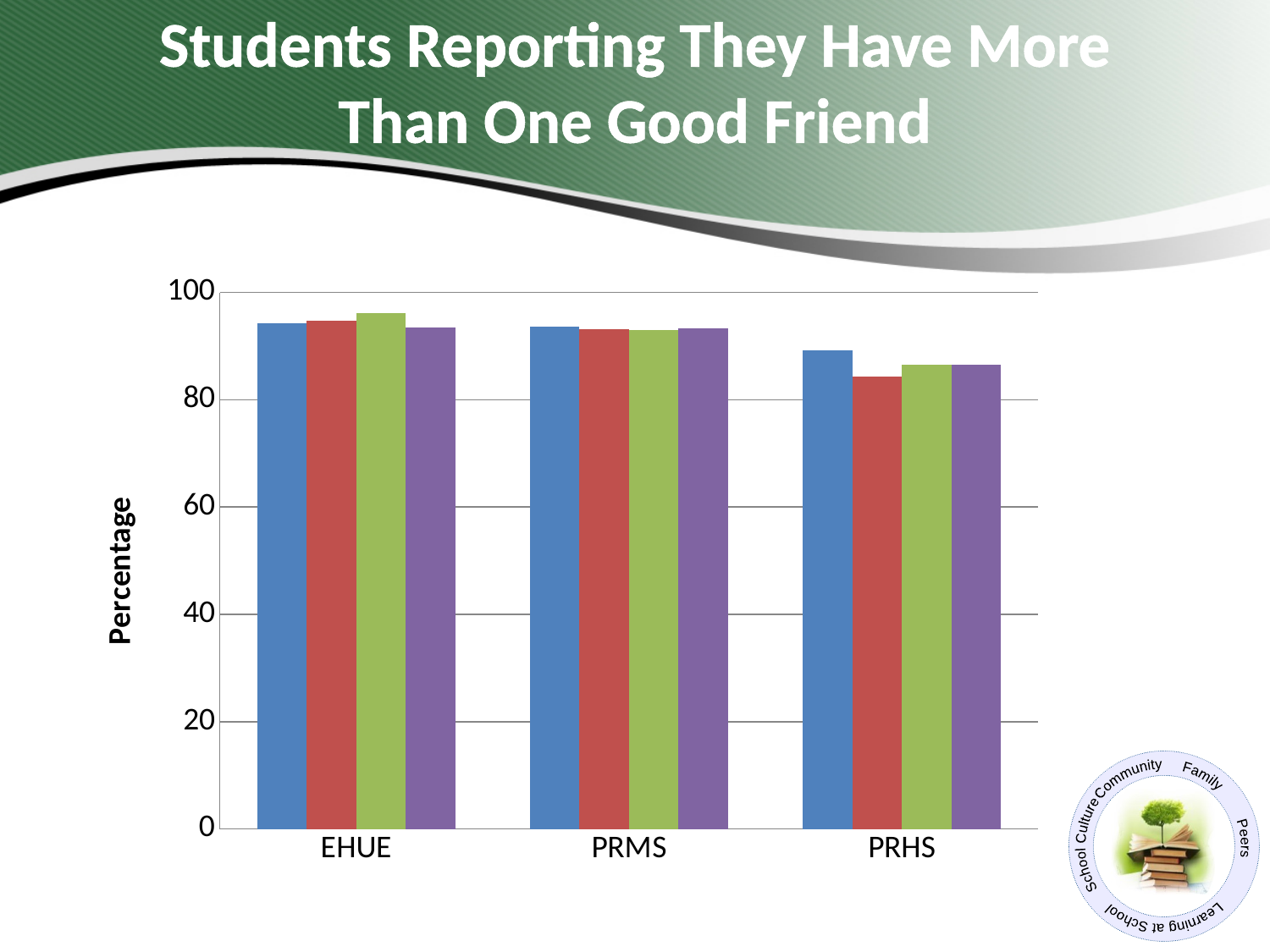
Which is larger for PRHS, the blue bar or the red bar? the blue bar How many categories are shown on the x axis of the chart? 3 Is the value of the blue bar for PRMS greater or less than 80? greater Is the value of the green bar for EHUE greater or less than 100? less What kind of chart is shown on the slide? bar chart Is the value of the red bar for PRHS greater or less than 80? greater Which category has the lowest red bar? PRHS Which is larger, the green bar for EHUE or the green bar for PRHS? the green bar for EHUE What is the label on the vertical axis of the chart? Percentage What is the title of the chart on the slide? Students Reporting They Have More Than One Good Friend How many bars are shown for each category in the chart? 4 Which category has the highest green bar? EHUE